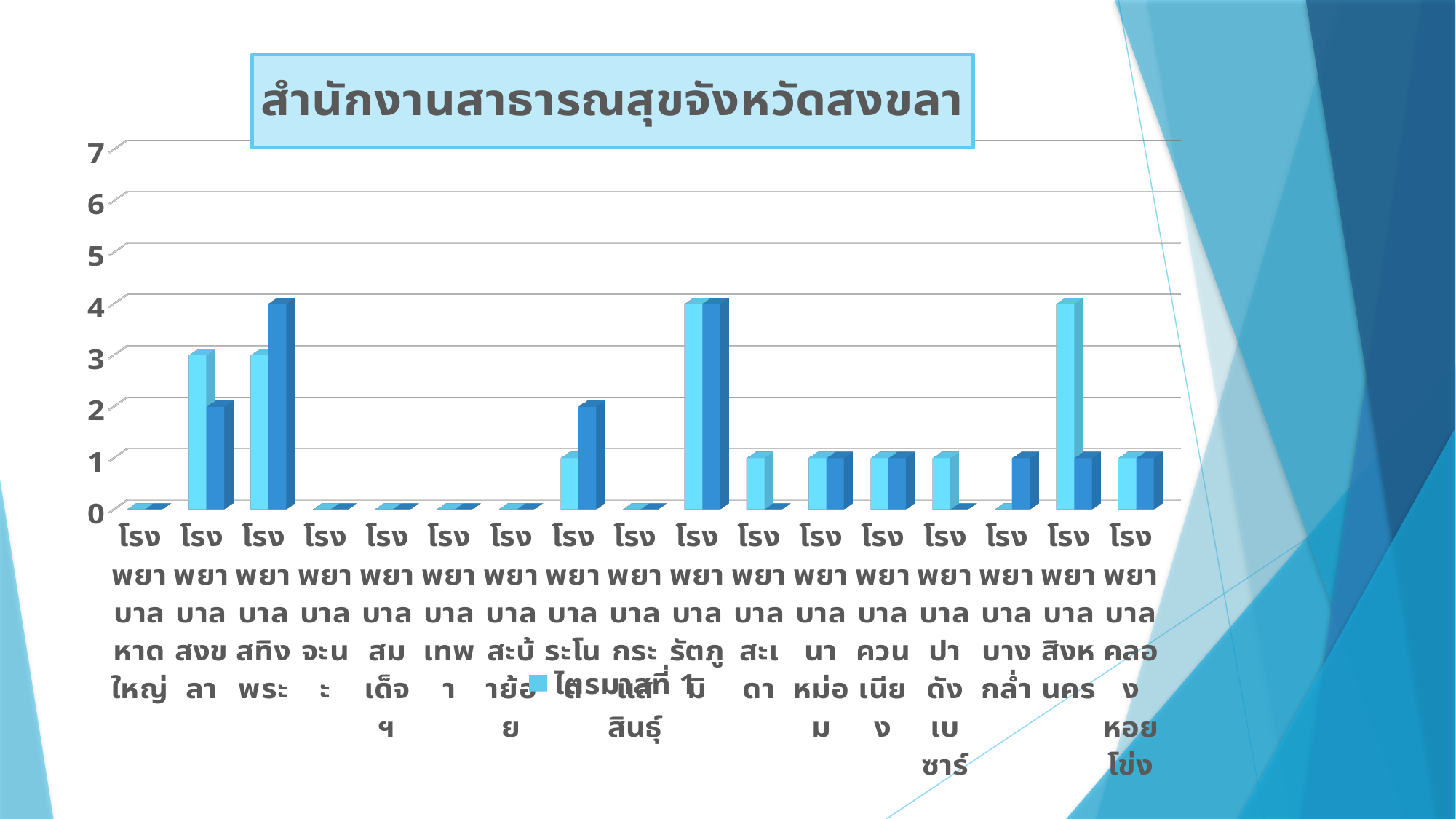
How many hospital categories are shown on the x axis? 17 For โรงพยาบาลสทิงพระ, which bar is larger, the light blue or the dark blue? dark blue What is the value of the dark blue bar for โรงพยาบาลสทิงพระ? 4 What is the value of the light blue bar for โรงพยาบาลสงขลา? 3 What is the title of the chart? สำนักงานสาธารณสุขจังหวัดสงขลา What is the value of the light blue bar for โรงพยาบาลสิงหนคร? 4 What is the highest value shown on the vertical axis? 7 Is the light blue bar for โรงพยาบาลสงขลา greater or less than 2? greater What is the value of the dark blue bar for โรงพยาบาลระโนด? 2 What kind of chart is shown on the slide? bar chart What is the difference between the dark blue and light blue bars for โรงพยาบาลสทิงพระ? 1 What is the value of the light blue bar for โรงพยาบาลรัตภูมิ? 4